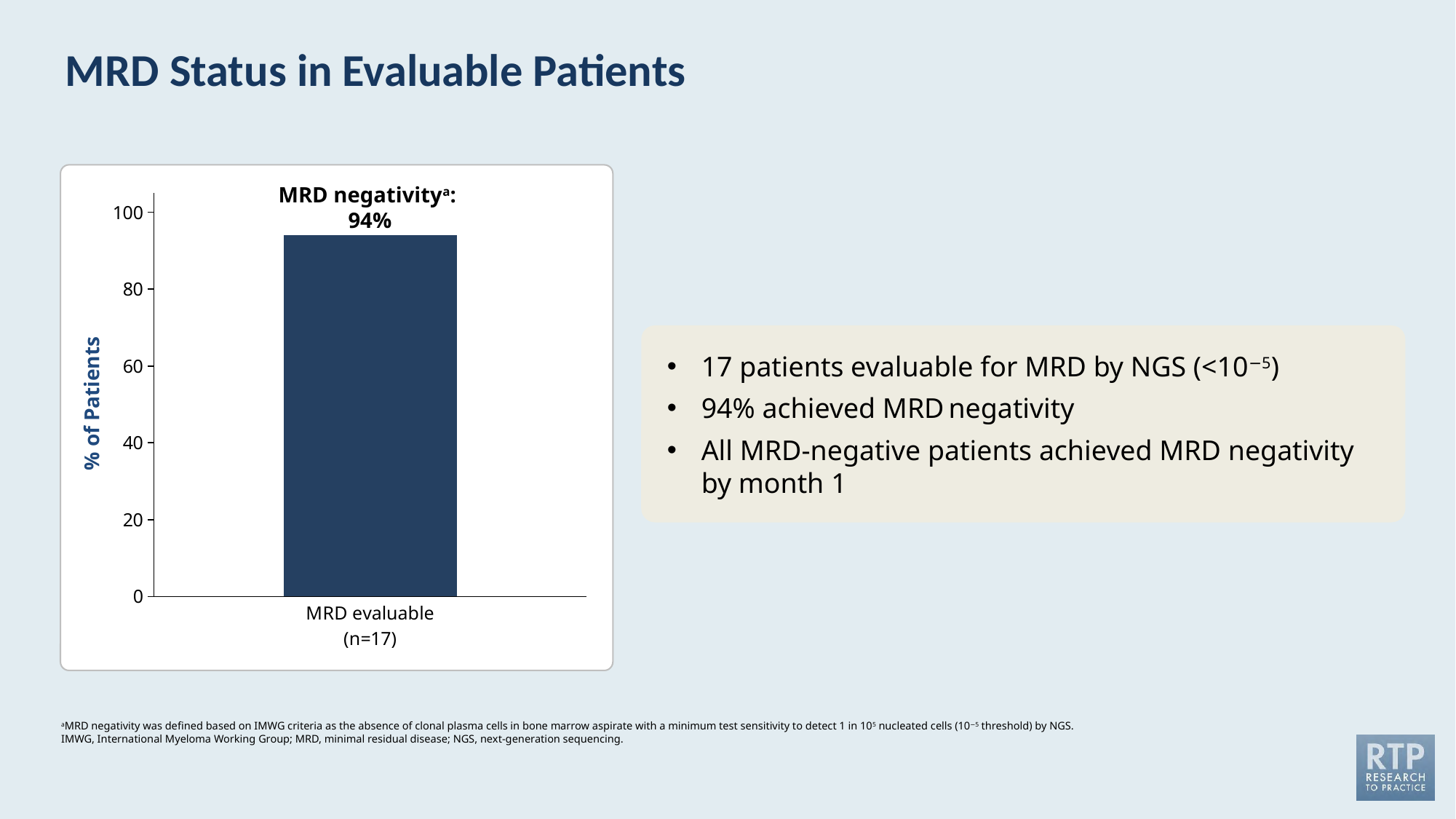
What is the category label under the bar? MRD evaluable (n=17) How many bars does the chart show? 1 What is the label of the y-axis on the chart? % of Patients Is the value of the MRD evaluable bar greater or less than 100? less Is the value of the MRD evaluable bar greater or less than 80? greater What is the maximum value shown on the y-axis of the chart? 100 What is the MRD negativity rate shown for the MRD evaluable group? 94% What kind of chart is shown on the slide? bar chart How many patients are in the MRD evaluable group shown on the chart? 17